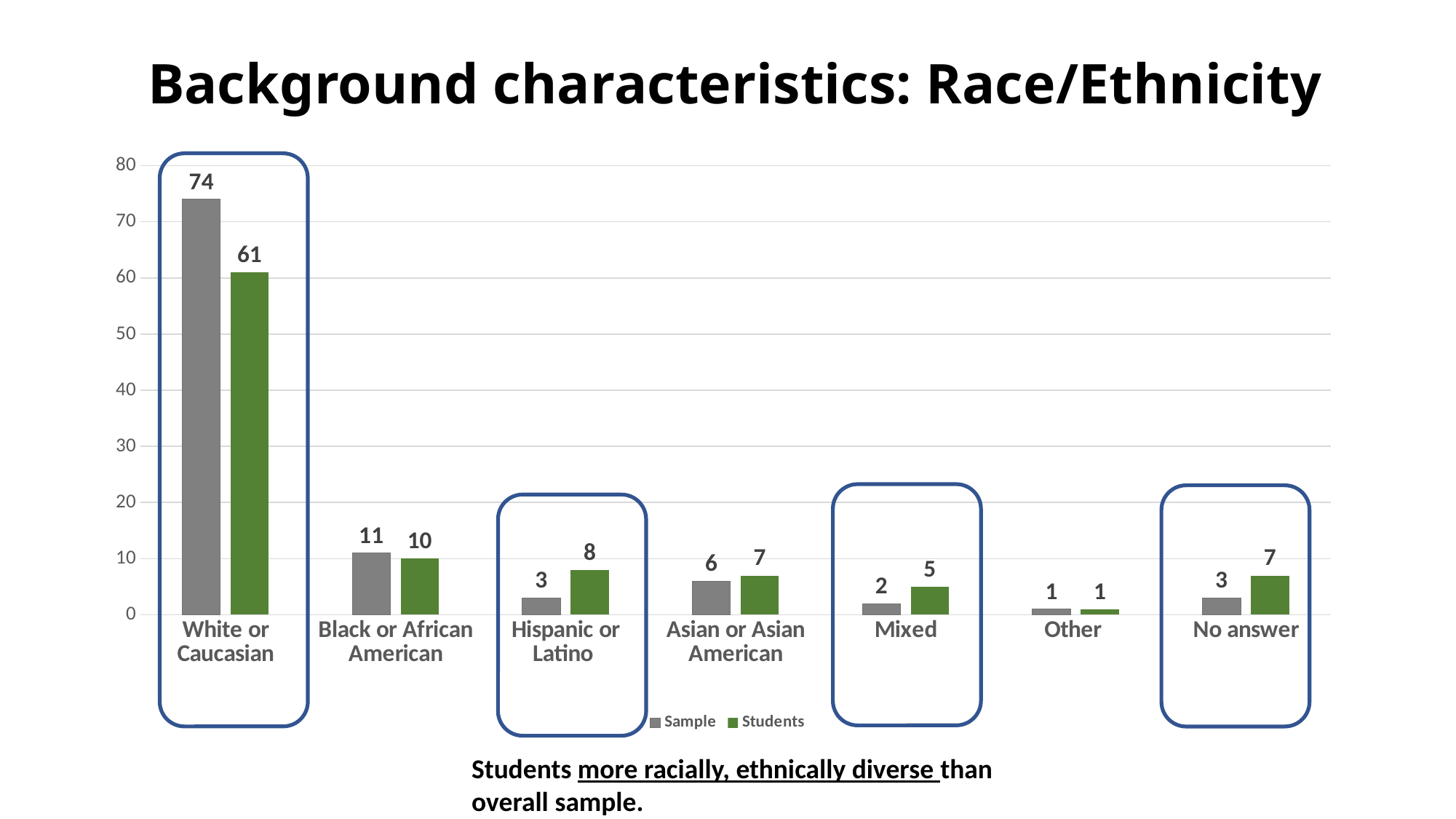
What is the Students value for No answer? 7 How many series does the legend list? 2 What kind of chart is shown on the slide? bar chart Which category has the lowest Sample value? Other Which category has the highest Students value? White or Caucasian What colour are the Students bars? green What is the Sample value for White or Caucasian? 74 Is the Students value for White or Caucasian greater or less than 50? greater What is the difference between the Sample and Students values for White or Caucasian? 13 How many race/ethnicity categories are shown on the x axis? 7 For Mixed, which series has the larger value, Sample or Students? Students What is the Students value for Hispanic or Latino? 8